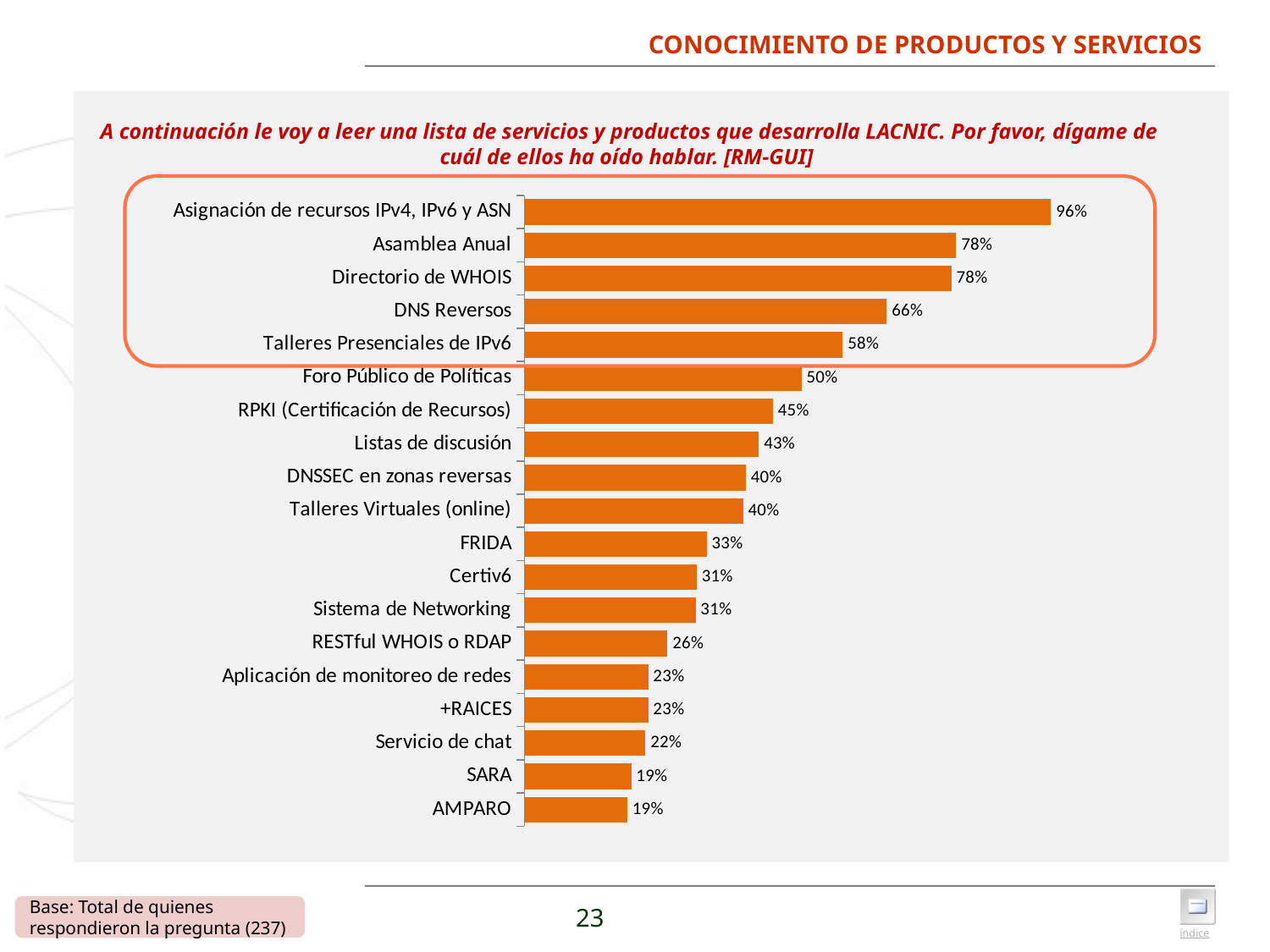
What is the value for Asignación de recursos IPv4, IPv6 y ASN? 96% What is the difference between the values for Talleres Presenciales de IPv6 and Talleres Virtuales (online)? 18% What colour are the bars in the chart? Orange How many categories are shown in the chart? 19 What is the value for DNS Reversos? 66% Which is larger, the value for FRIDA or the value for Certiv6? FRIDA What is the value for RPKI (Certificación de Recursos)? 45% What is the lowest value shown in the chart? 19% Which category has the highest value? Asignación de recursos IPv4, IPv6 y ASN What kind of chart is shown on the slide? Bar chart What is the value for RESTful WHOIS o RDAP? 26% What is the difference between the values for Asamblea Anual and Foro Público de Políticas? 28%